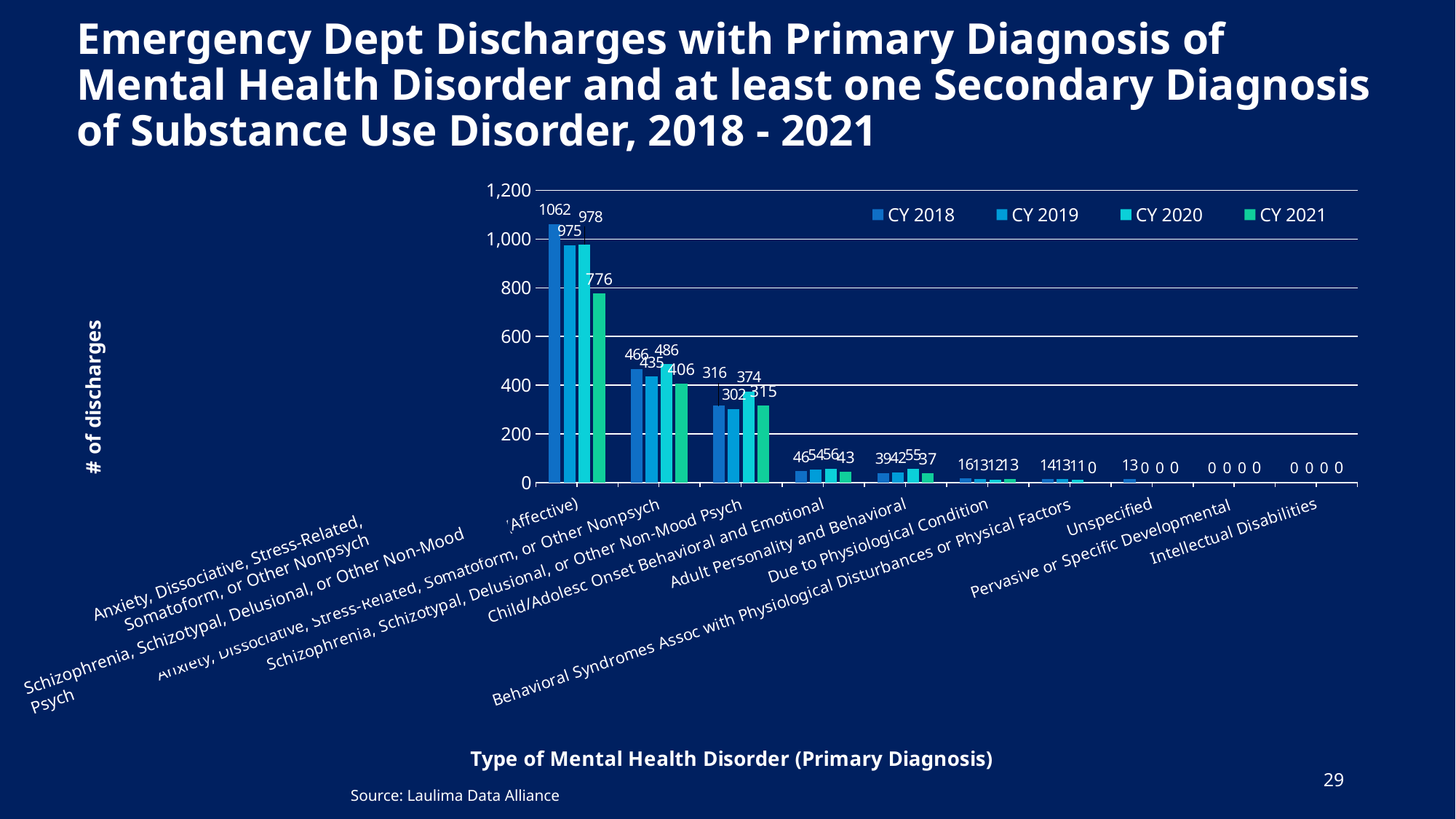
How many categories of mental health disorder are shown on the x axis? 10 What is the difference between the CY 2020 and CY 2019 values for Schizophrenia, Schizotypal, Delusional, or Other Non-Mood Psych? 72 What is the CY 2019 value for Child/Adolesc Onset Behavioral and Emotional? 54 What type of chart is shown on the slide? bar chart Is the CY 2018 value for Anxiety, Dissociative, Stress-Related, Somatoform, or Other Nonpsych greater or less than 400? greater What is the CY 2018 value for Unspecified? 13 What is the CY 2021 value for Schizophrenia, Schizotypal, Delusional, or Other Non-Mood Psych? 315 Which year has the highest value for Adult Personality and Behavioral? CY 2020 What is the CY 2020 value for Anxiety, Dissociative, Stress-Related, Somatoform, or Other Nonpsych? 486 Which year has the lowest value for Anxiety, Dissociative, Stress-Related, Somatoform, or Other Nonpsych? CY 2021 How many series does the legend list? 4 What is the label of the y axis? # of discharges